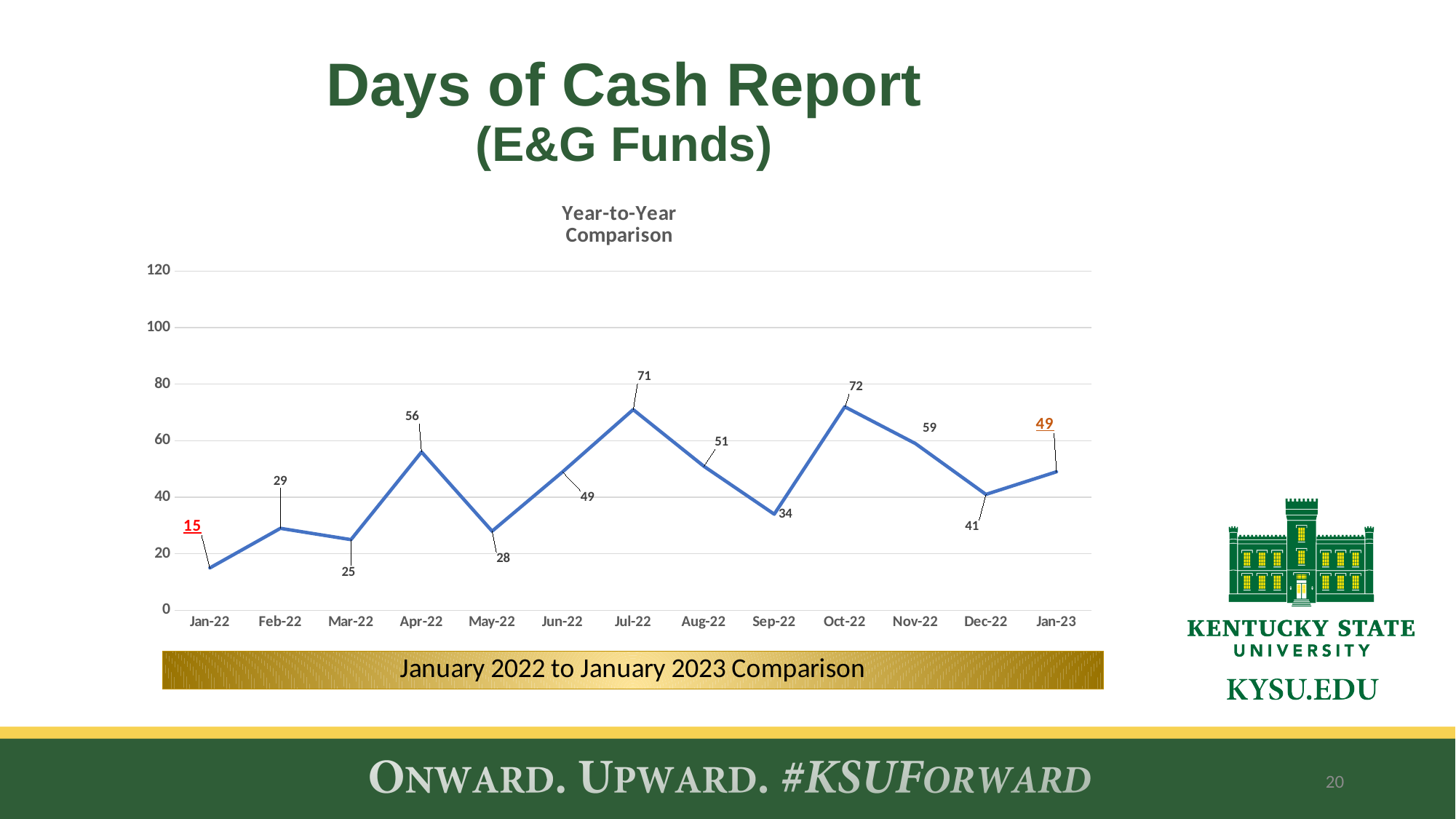
What is the title of the chart? Year-to-Year Comparison What kind of chart is shown? line chart How many months are plotted on the chart? 13 What is the difference between the values for Jan-23 and Jan-22? 34 Is the value for Sep-22 greater or less than 40? less What is the value for Jul-22? 71 Do the values rise or fall from Oct-22 to Dec-22? fall Which is larger, the value for Apr-22 or the value for Nov-22? Nov-22 Which month has the highest value? Oct-22 What is the value for Jan-22? 15 Which month has the lowest value? Jan-22 What is the value for Jan-23? 49